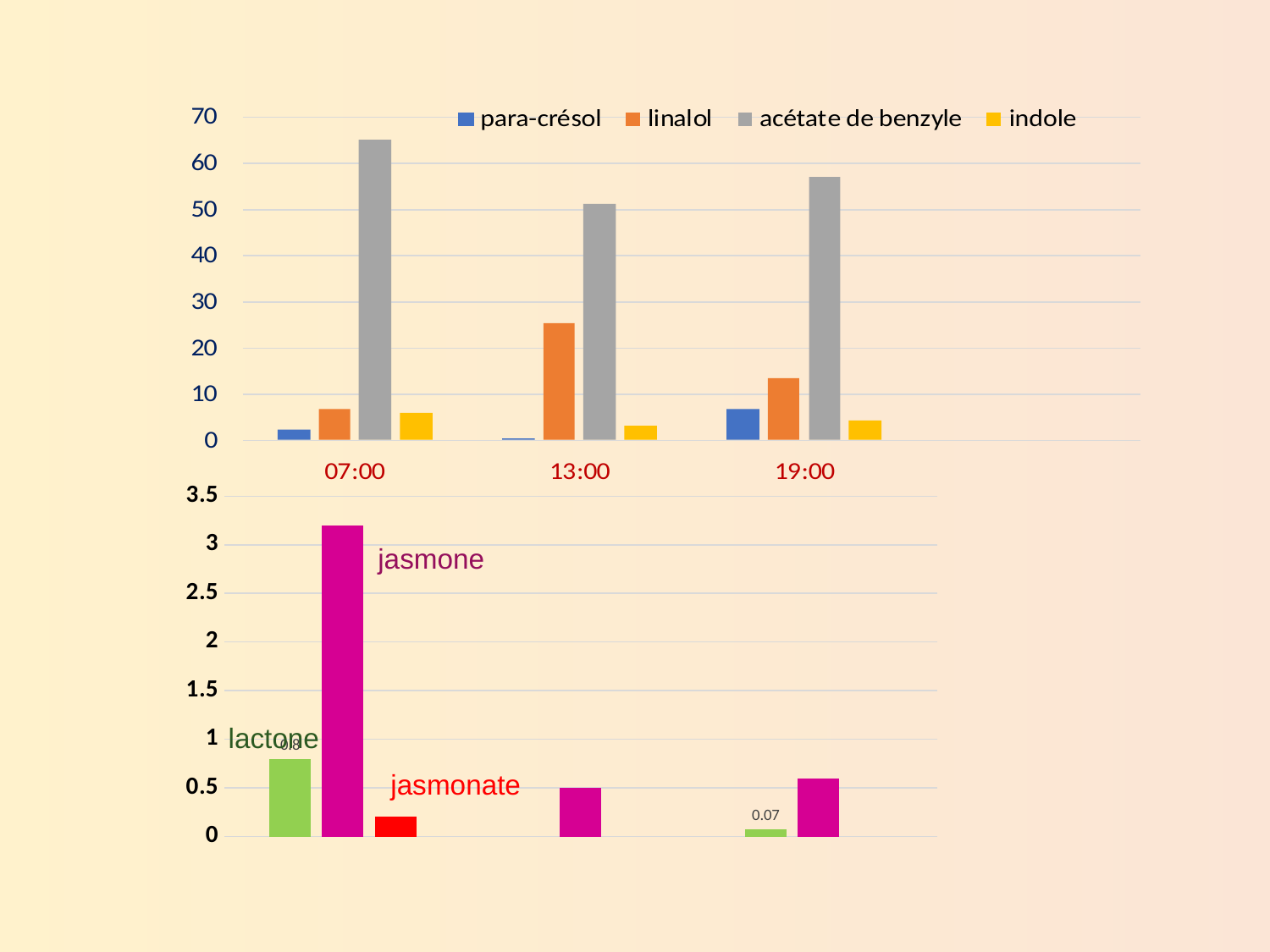
In the top chart, is the value for acétate de benzyle at 07:00 greater or less than 60? greater How many series does the legend of the top chart list? 4 In the bottom chart, what value is printed on the small green lactone bar in the rightmost group? 0.07 In the top chart, is the value for linalol at 13:00 greater or less than 20? greater In the top chart, is the value for indole at 07:00 greater or less than 10? less In the top chart, at which time is the value for acétate de benzyle highest? 07:00 In the top chart, which is larger: linalol at 13:00 or linalol at 19:00? linalol at 13:00 What kind of chart is the top chart on the slide? bar chart How many time categories are shown on the x axis of the top chart? 3 In the top chart, does the value for linalol rise or fall from 07:00 to 13:00? rise In the top chart, which series has the lowest value at 13:00? para-crésol